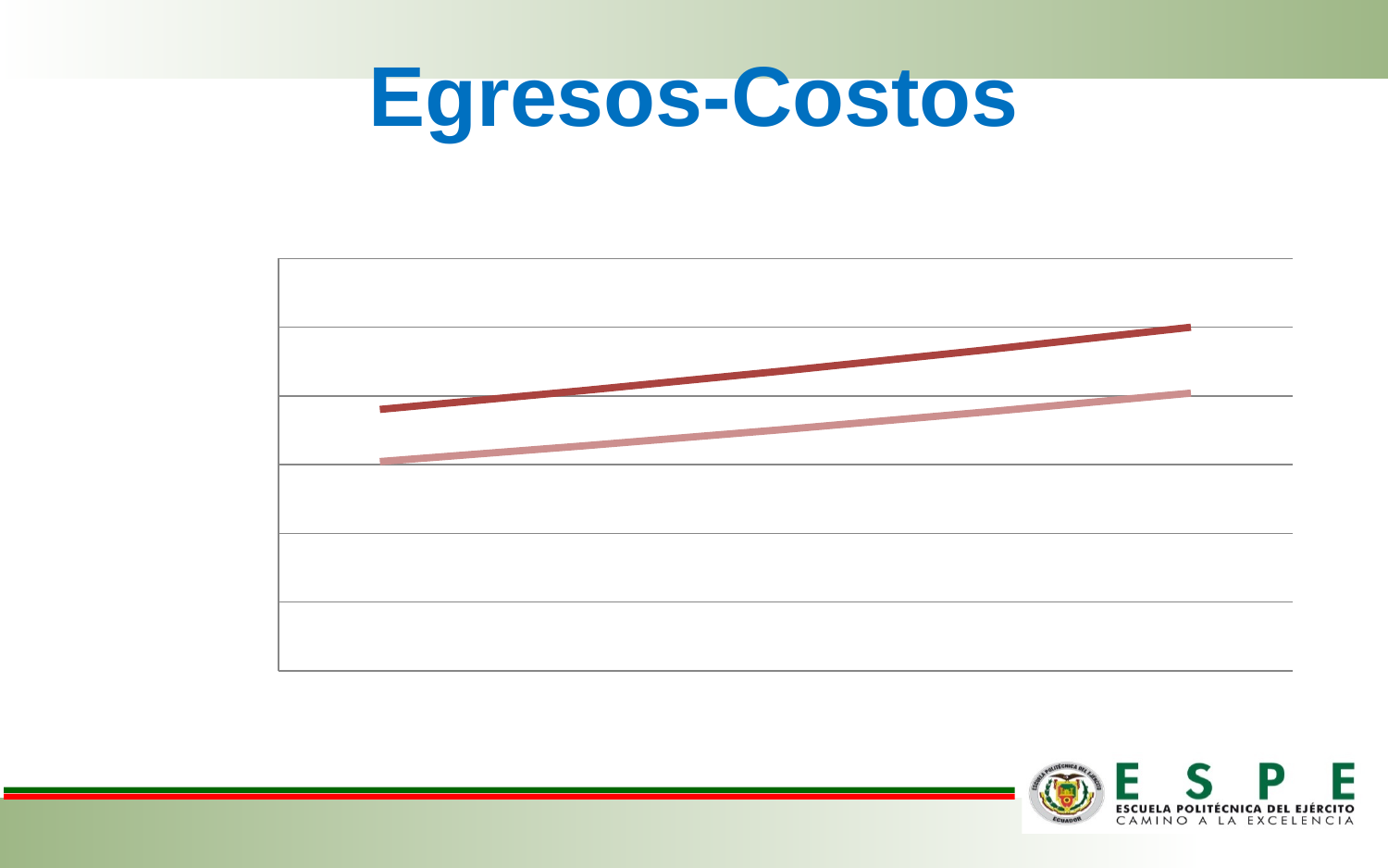
What is the title shown above the chart on the slide? Egresos-Costos What kind of chart is shown on the slide? line chart Do the values of the light pink line rise or fall from left to right? rise Which line is plotted higher on the chart, the dark red line or the light pink line? the dark red line How many lines are plotted on the chart? 2 Do the values of the dark red line rise or fall from left to right? rise Does the chart display a legend? No